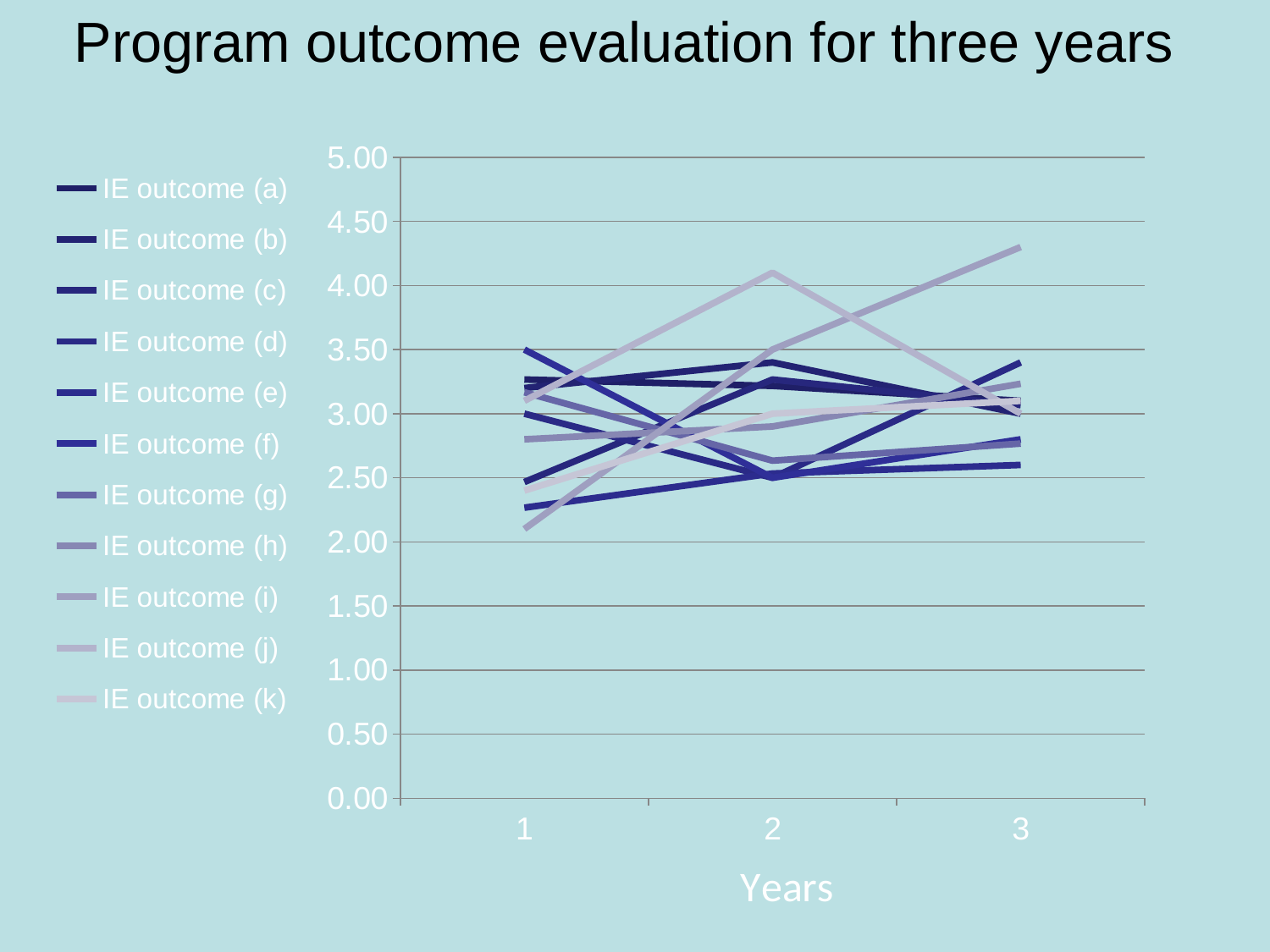
What kind of chart is shown on the slide? line chart What is the label of the x axis? Years Is the lowest value plotted at year 1 greater or less than 2.50? less Is the highest value plotted at year 3 greater or less than 4.00? greater Is the highest value plotted at year 1 greater or less than 4.00? less How many series does the legend list? 11 How many points are there along the x axis (Years)? 3 What is the title of the slide's chart? Program outcome evaluation for three years